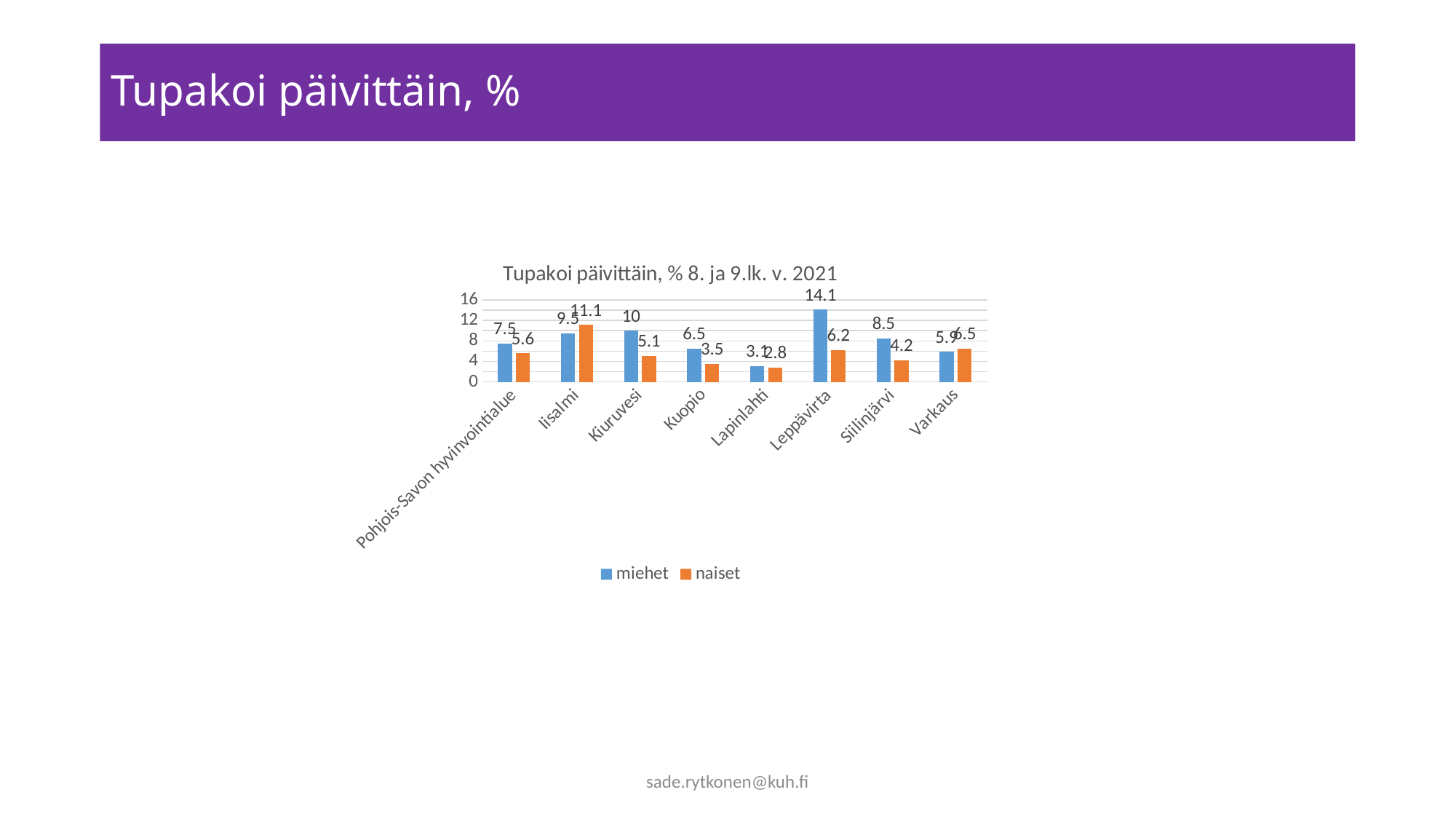
How many series does the legend list? 2 What type of chart is shown on the slide? bar chart What is the value for naiset in Kuopio? 3.5 How many categories are shown on the x axis? 8 What is the value for miehet in Kiuruvesi? 10 In Pohjois-Savon hyvinvointialue, which is larger, miehet or naiset? miehet What is the value for naiset in Iisalmi? 11.1 Which category has the highest value for naiset? Iisalmi What is the value for miehet in Leppävirta? 14.1 What is the title of the chart? Tupakoi päivittäin, % 8. ja 9.lk. v. 2021 Which category has the highest value for miehet? Leppävirta What is the difference between miehet and naiset in Siilinjärvi? 4.3